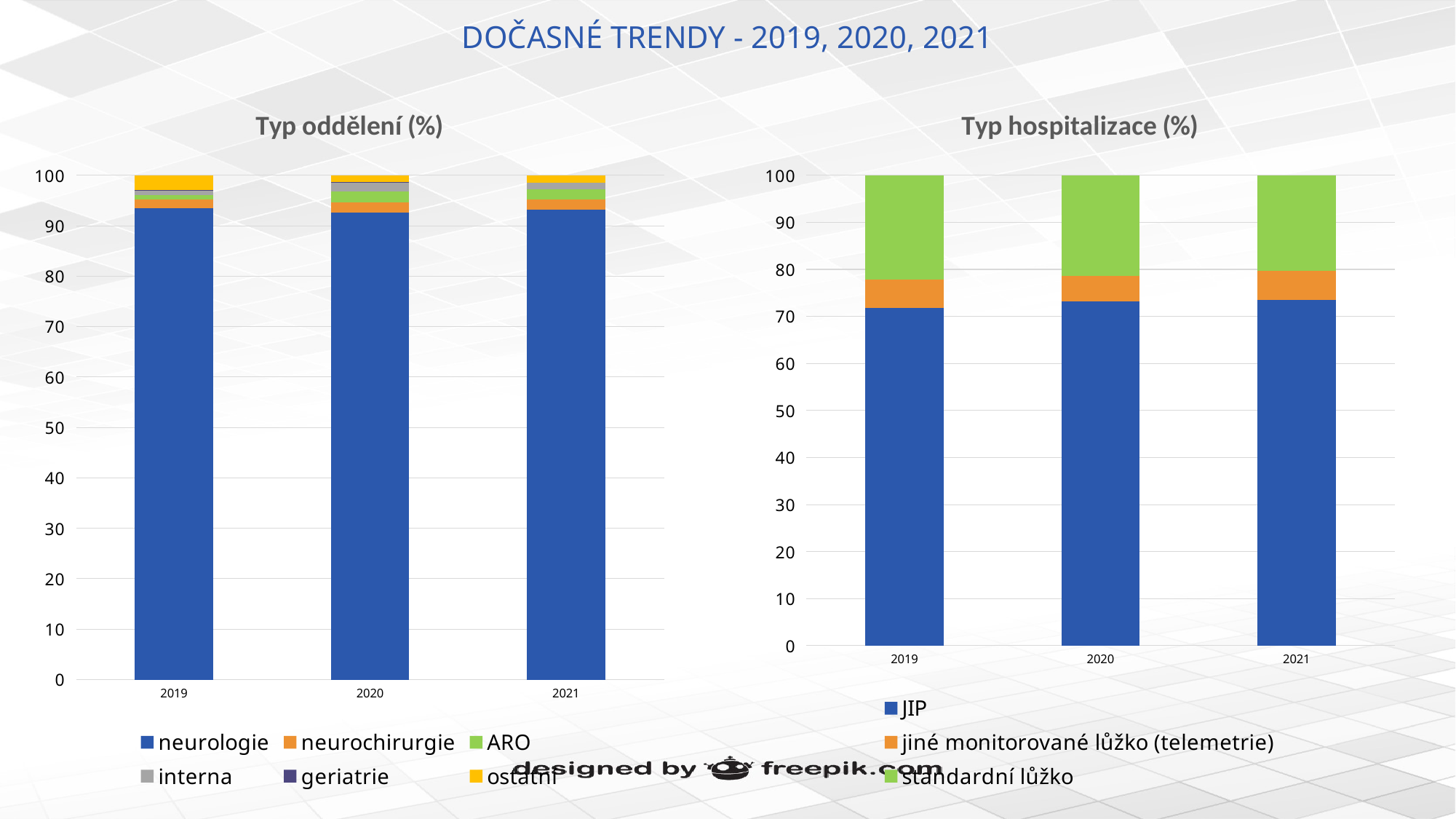
In the 'Typ oddělení (%)' chart, how many years are shown on the x axis? 3 In the 'Typ hospitalizace (%)' chart, what is the total of the stacked bar for 2019? 100 What kind of chart is the 'Typ oddělení (%)' chart on the left? stacked bar chart What is the title of the chart on the right side of the slide? Typ hospitalizace (%) In the 'Typ hospitalizace (%)' chart, which series has the largest share in 2020? JIP In the 'Typ hospitalizace (%)' chart, is the value for JIP in 2019 greater or less than 70? greater In the 'Typ hospitalizace (%)' chart, is the value for JIP in 2021 greater or less than 80? less What kind of chart is the 'Typ hospitalizace (%)' chart on the right? stacked bar chart In the 'Typ oddělení (%)' chart, which series has the largest share in every year? neurologie In the 'Typ oddělení (%)' chart, is the value for neurologie in 2019 greater or less than 90? greater In the 'Typ oddělení (%)' chart, how many series does the legend list? 6 In the 'Typ hospitalizace (%)' chart, how many series does the legend list? 3